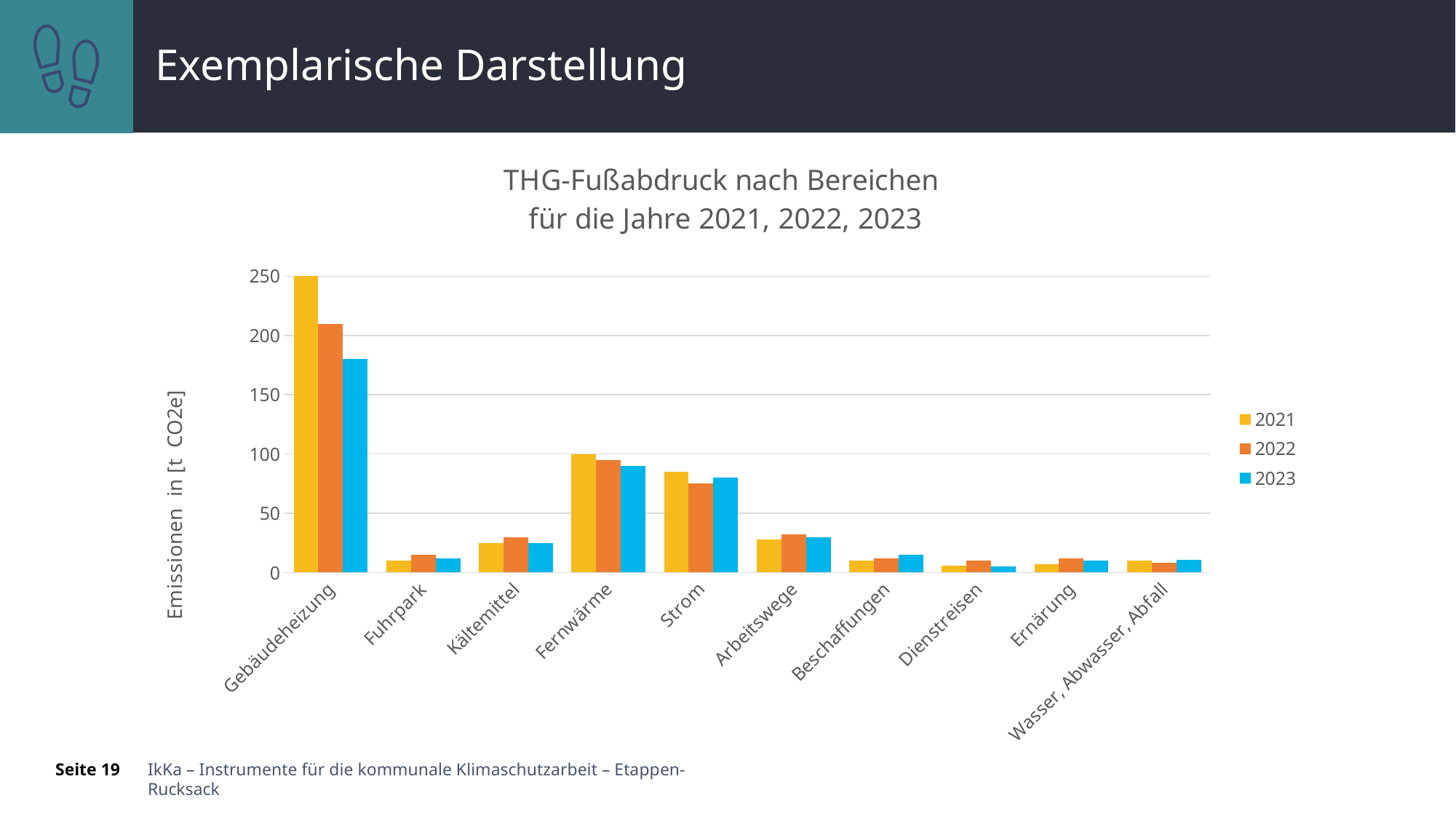
For Gebäudeheizung, which year has the larger value: 2022 or 2023? 2022 How many series does the legend list? 3 Which is larger for 2021: Fernwärme or Strom? Fernwärme What is the value for Gebäudeheizung in 2021? 250 Which category has the highest emissions in 2021? Gebäudeheizung What kind of chart is shown on the slide? bar chart Is the value for Gebäudeheizung in 2023 greater or less than 150? greater What is the label of the y axis? Emissionen in [t CO2e] Is the value for Strom in 2021 greater or less than 100? less Do the values for Gebäudeheizung rise or fall from 2021 to 2023? fall Is the value for Fuhrpark in 2022 greater or less than 50? less How many categories are shown on the x axis? 10